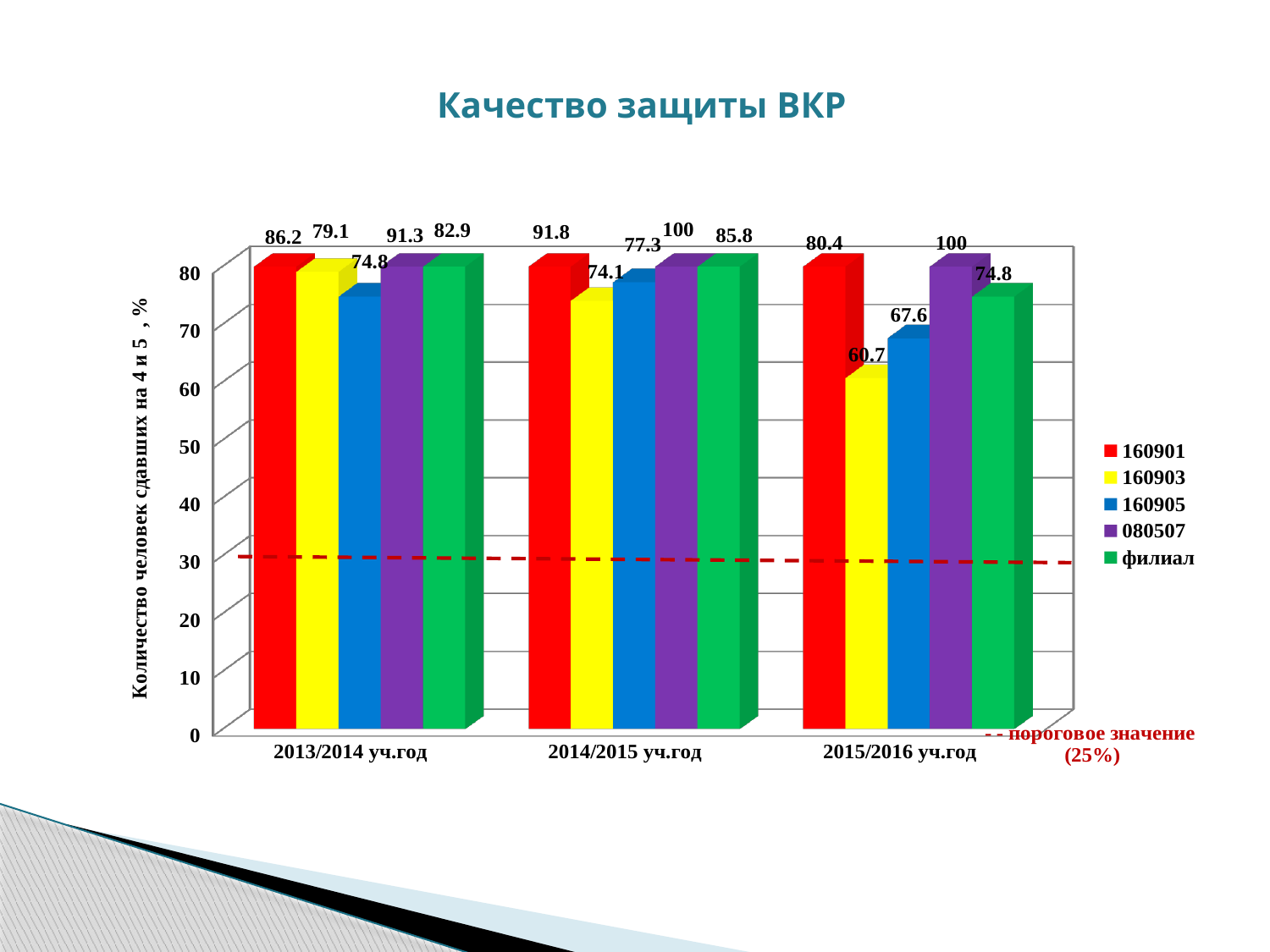
What is the value for 080507 in 2014/2015 уч.год? 100 What is the value for 160901 in 2013/2014 уч.год? 86.2 How many academic years (categories) are shown on the x axis? 3 Which is larger in 2014/2015 уч.год: the value for 160905 or the value for филиал? филиал What is the value for филиал in 2015/2016 уч.год? 74.8 What is the value for 160903 in 2015/2016 уч.год? 60.7 How many series does the legend list? 5 Does the value for 160903 rise or fall from 2013/2014 уч.год to 2015/2016 уч.год? fall What is the difference between the values for 160901 and 160903 in 2014/2015 уч.год? 17.7 What kind of chart is shown on the slide? bar chart Which series has the highest value in 2013/2014 уч.год? 080507 Which series has the lowest value in 2015/2016 уч.год? 160903